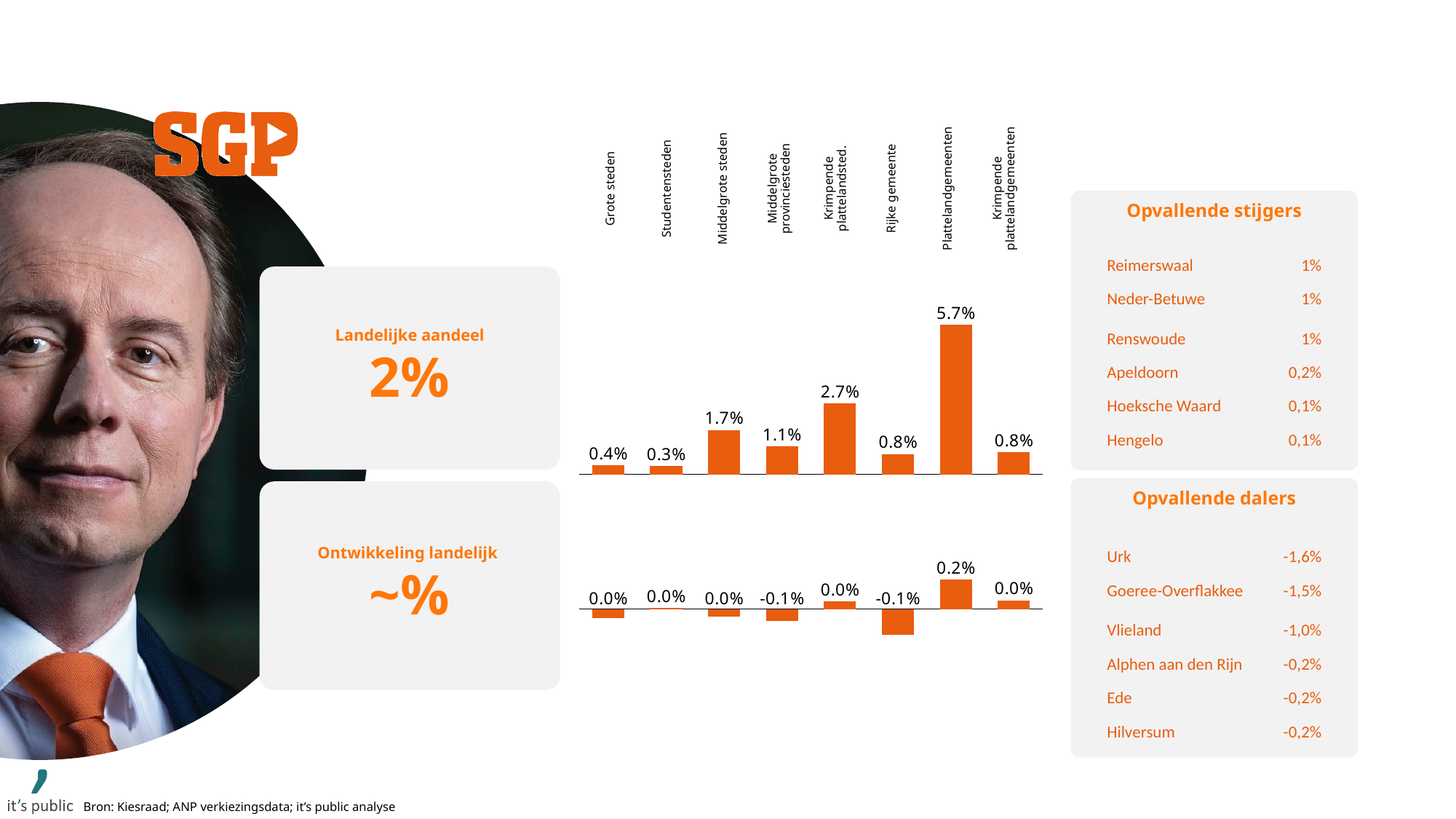
In the bottom chart (Ontwikkeling landelijk), which category has the highest value? Plattelandgemeenten In the top chart (Landelijke aandeel), what is the value for Plattelandgemeenten? 5.7% In the bottom chart (Ontwikkeling landelijk), what is the value for Plattelandgemeenten? 0.2% In the top chart (Landelijke aandeel), which category has the highest value? Plattelandgemeenten In the bottom chart (Ontwikkeling landelijk), what is the value for Rijke gemeente? -0.1% How many categories are shown in the top chart (Landelijke aandeel)? 8 What is the value shown for Landelijke aandeel in the box to the left of the top chart? 2% What kind of chart is the top chart (Landelijke aandeel)? Bar chart In the top chart (Landelijke aandeel), what is the value for Krimpende plattelandsted.? 2.7% In the top chart (Landelijke aandeel), which category has the lowest value? Studentensteden In the top chart (Landelijke aandeel), what is the difference between Plattelandgemeenten and Krimpende plattelandsted.? 3.0% In the top chart (Landelijke aandeel), which is larger: Middelgrote steden or Middelgrote provinciesteden? Middelgrote steden